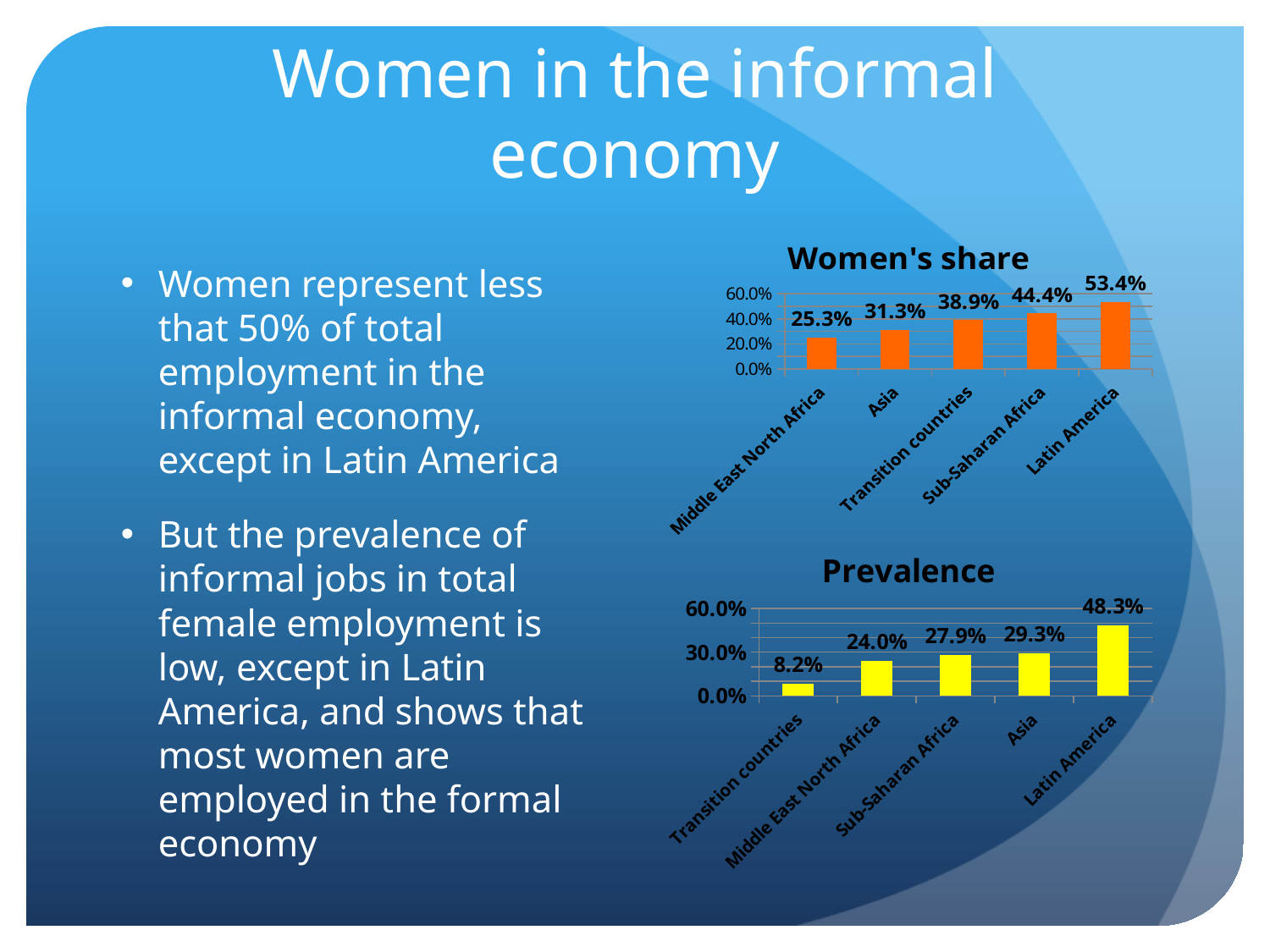
In the "Women's share" chart, what is the value for Latin America? 53.4% In the "Prevalence" chart, what is the value for Sub-Saharan Africa? 27.9% In the "Prevalence" chart, what is the value for Transition countries? 8.2% In the "Women's share" chart, what is the value for Middle East North Africa? 25.3% In the "Prevalence" chart, what is the difference between Latin America and Transition countries? 40.1% In the "Women's share" chart, which category has the lowest value? Middle East North Africa In the "Women's share" chart, what is the difference between Latin America and Asia? 22.1% What type of chart is the "Prevalence" chart? bar chart In the "Women's share" chart, how many categories are shown? 5 In the "Prevalence" chart, which is larger, Asia or Middle East North Africa? Asia In the "Prevalence" chart, which category has the highest value? Latin America In the "Women's share" chart, do the values rise or fall from left to right? rise